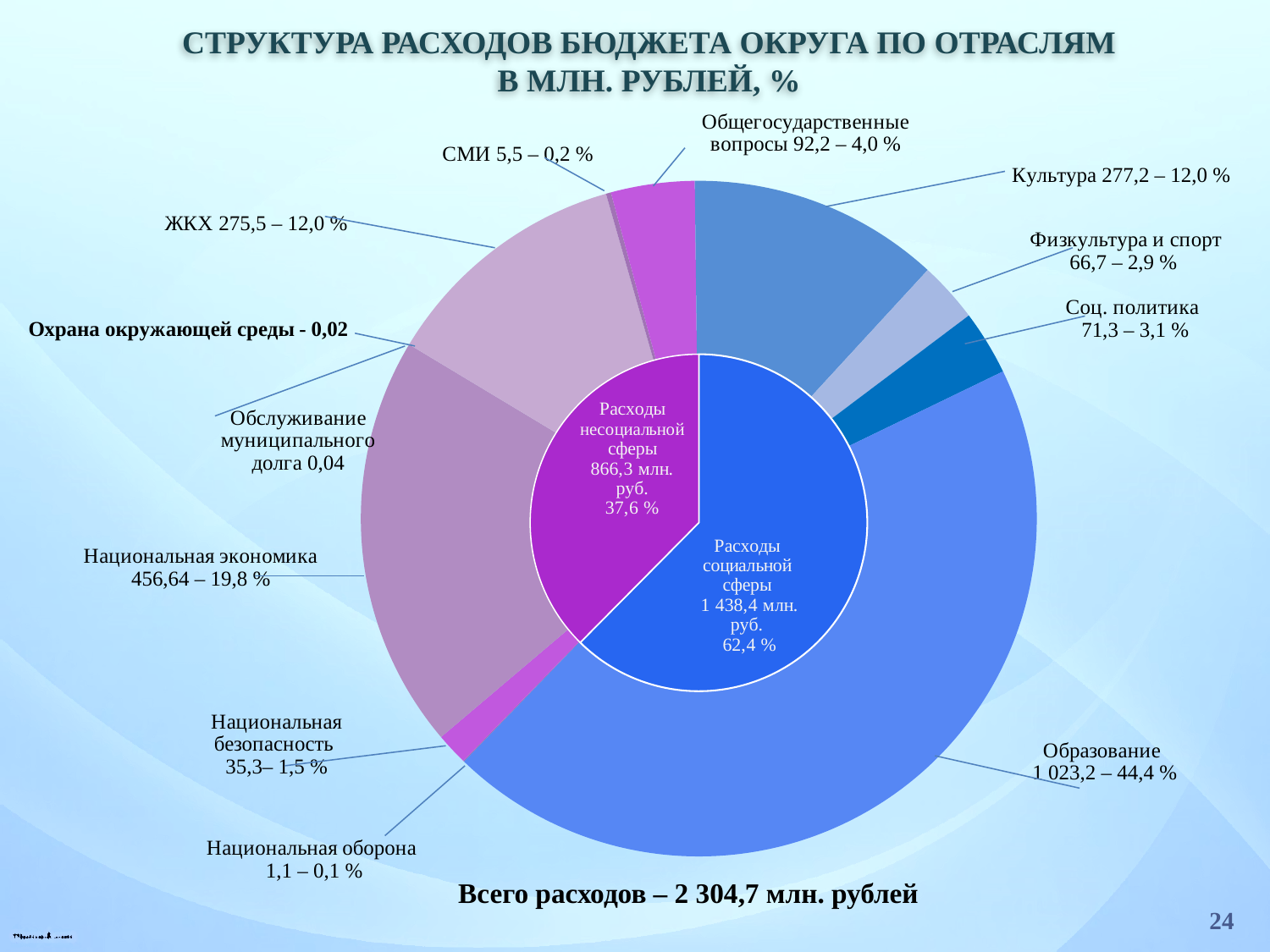
What is the difference in million rubles between Культура (277,2) and ЖКХ (275,5)? 1,7 Which sector has the smallest expenditure? Охрана окружающей среды Which is larger: Культура or Физкультура и спорт? Культура What is the value for Образование in million rubles? 1 023,2 What is the total of all expenditures shown on the slide? 2 304,7 млн. рублей What is the value for Национальная экономика in million rubles? 456,64 Which sector has the largest expenditure? Образование What share do Расходы несоциальной сферы make up? 37,6 % What share of expenditures does Культура account for? 12,0 % What kind of chart is shown on the slide? pie chart What is the value for Расходы социальной сферы in the inner ring? 1 438,4 млн. руб. What share of expenditures does Образование account for? 44,4 %